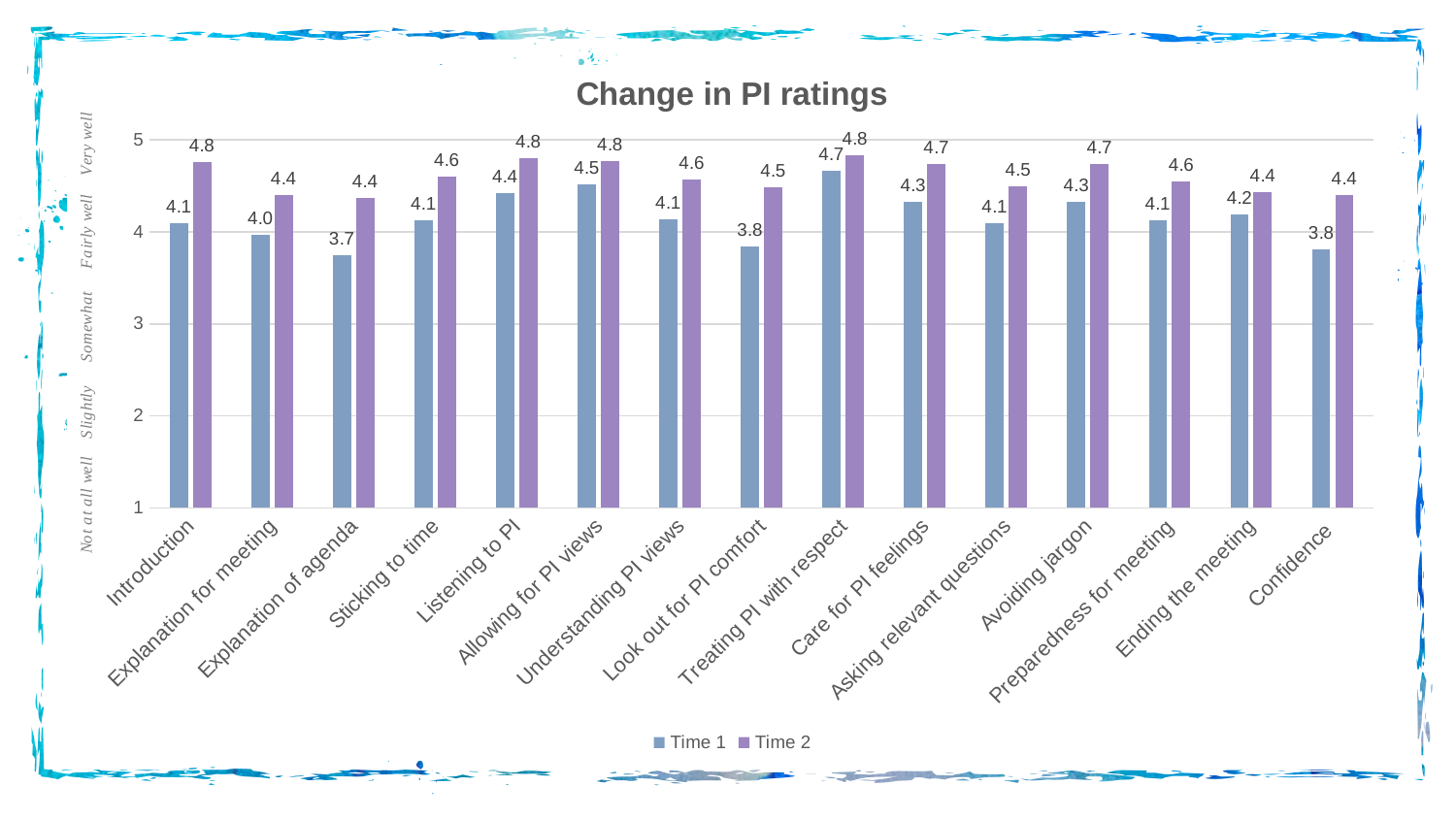
What is the Time 2 value for Confidence? 4.4 How many categories are shown on the x axis? 15 What is the Time 2 value for Look out for PI comfort? 4.5 What kind of chart is shown on the slide? Bar chart What is the Time 1 value for Treating PI with respect? 4.7 What is the title of the chart? Change in PI ratings Which is larger for Confidence: the Time 1 value or the Time 2 value? Time 2 Which category has the highest Time 1 value? Treating PI with respect How many series does the legend list? 2 Which category has the lowest Time 1 value? Explanation of agenda What is the Time 1 value for Explanation of agenda? 3.7 What is the difference between the Time 2 and Time 1 values for Introduction? 0.7